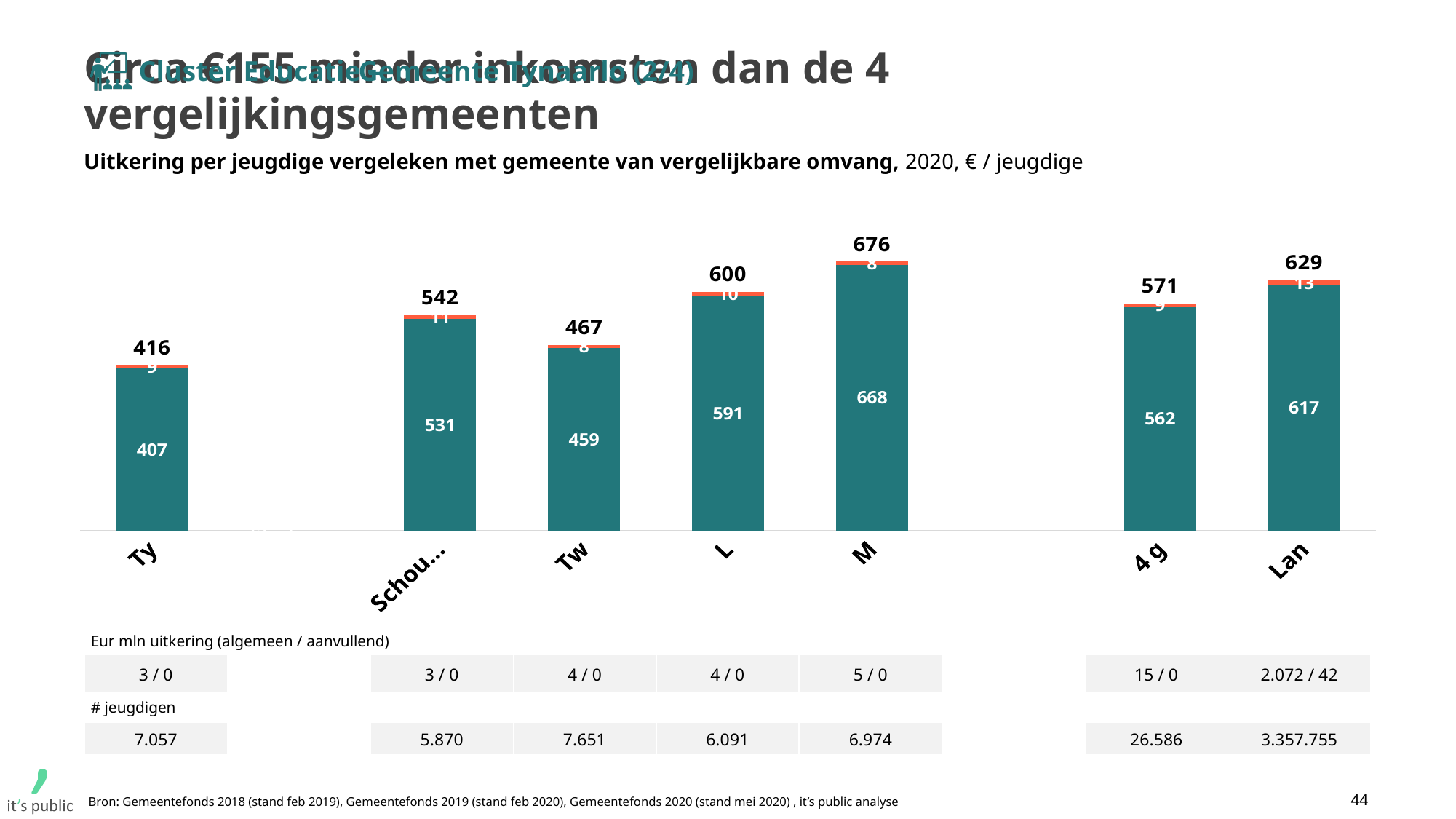
What kind of chart is shown on the slide? Stacked bar chart Which category has the highest total value? M Which category has the lowest total value? Ty What is the value of the large teal segment for Lan? 617 What is the difference between the total for Lan and the total for 4 g? 58 Which has a larger total, L or Tw? L What is the total value shown above the bar for Ty? 416 How many bars are shown in the chart? 7 What is the value of the teal segment for 4 g? 562 What is the total value shown above the bar for Schou...? 542 What is the difference between the total for M and the total for Ty? 260 What is the value of the teal segment for M? 668